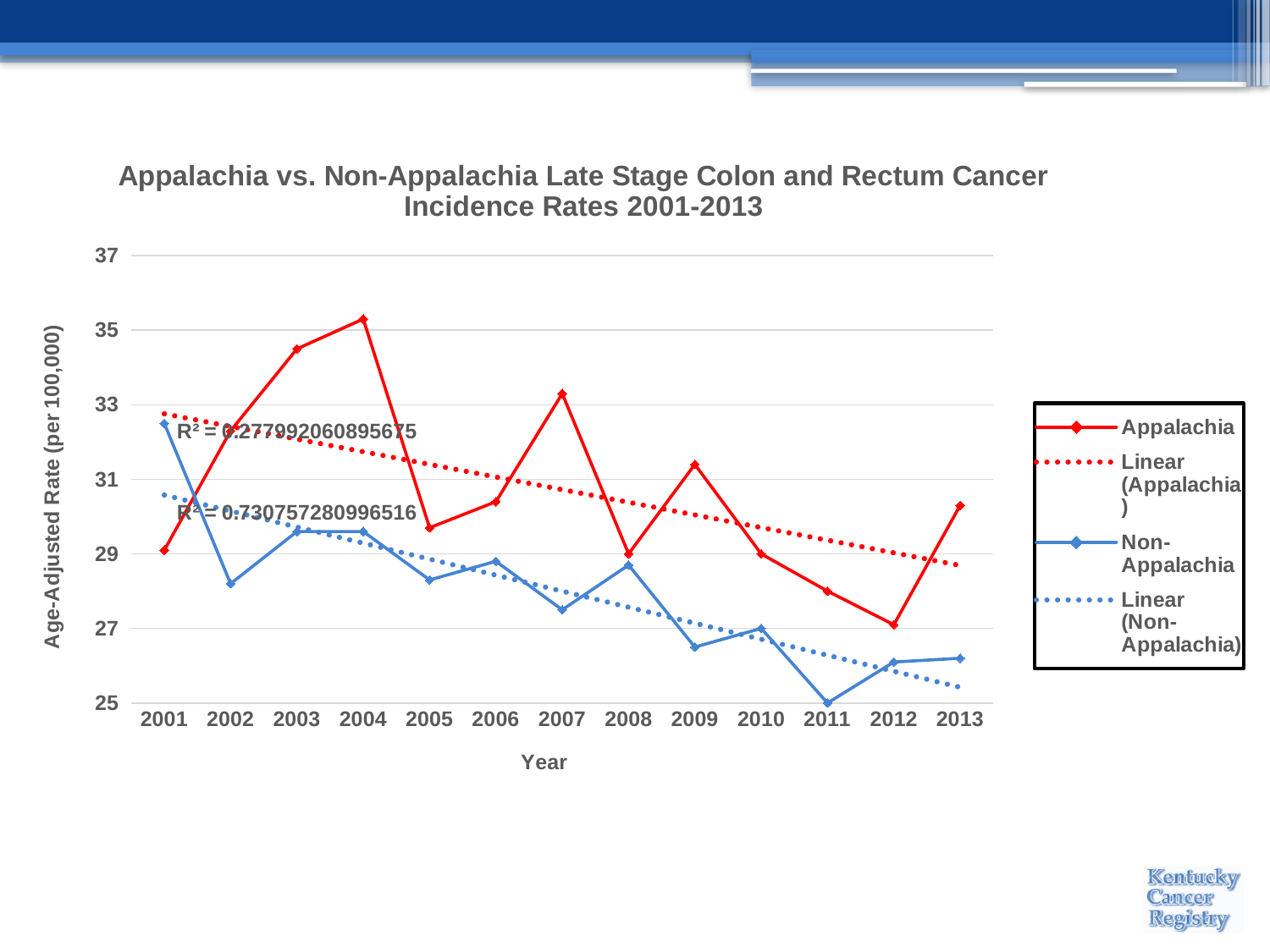
Overall, do the Non-Appalachia values rise or fall from 2001 to 2013? fall Is the Appalachia value for 2004 greater or less than 33? greater In which year does the Appalachia series reach its highest value? 2004 How many entries does the legend list? 4 Is the Non-Appalachia value for 2009 greater or less than 27? less What kind of chart is shown on the slide? Line chart In 2013, which series has the larger value, Appalachia or Non-Appalachia? Appalachia How many years are plotted along the x axis? 13 What is the title of the chart? Appalachia vs. Non-Appalachia Late Stage Colon and Rectum Cancer Incidence Rates 2001-2013 In which year does the Non-Appalachia series reach its lowest value? 2011 In which year does the Non-Appalachia series reach its highest value? 2001 In 2001, which series has the larger value, Appalachia or Non-Appalachia? Non-Appalachia